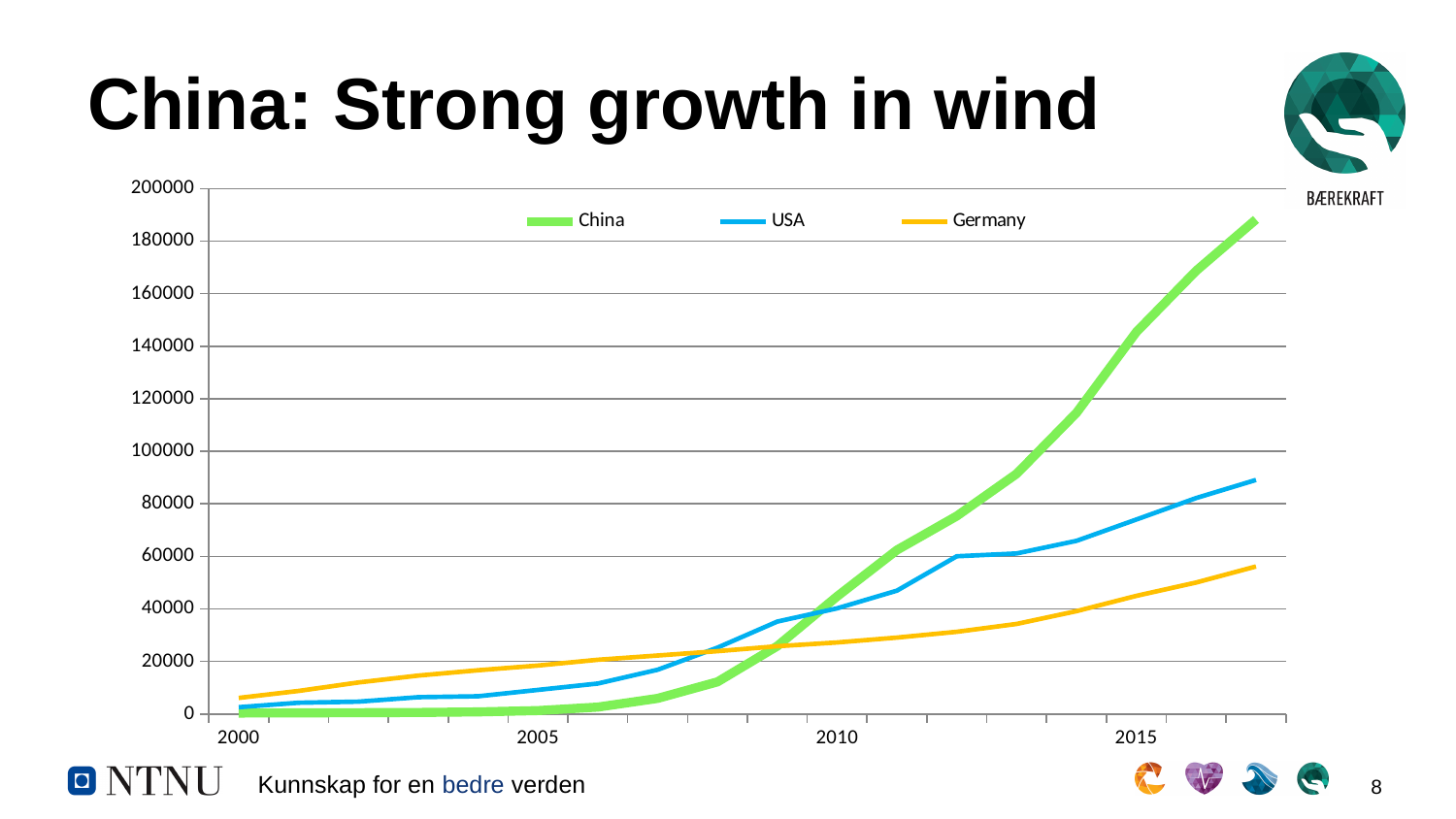
Which series has the highest value at the right end of the chart (2017)? China Is the value for China in 2017 greater or less than 160000? greater Is the value for China in 2005 greater or less than 20000? less Which series are listed in the legend? China, USA, Germany Which series has the lowest value at the right end of the chart (2017)? Germany Which series has the highest value in 2000? Germany What kind of chart is shown on the slide? line chart Is the value for USA in 2017 greater or less than 100000? less What is the title of the slide containing the chart? China: Strong growth in wind Does the China series rise or fall from 2000 to 2017? rise How many series does the legend list? 3 In 2012, which is larger, the value for China or the value for USA? China